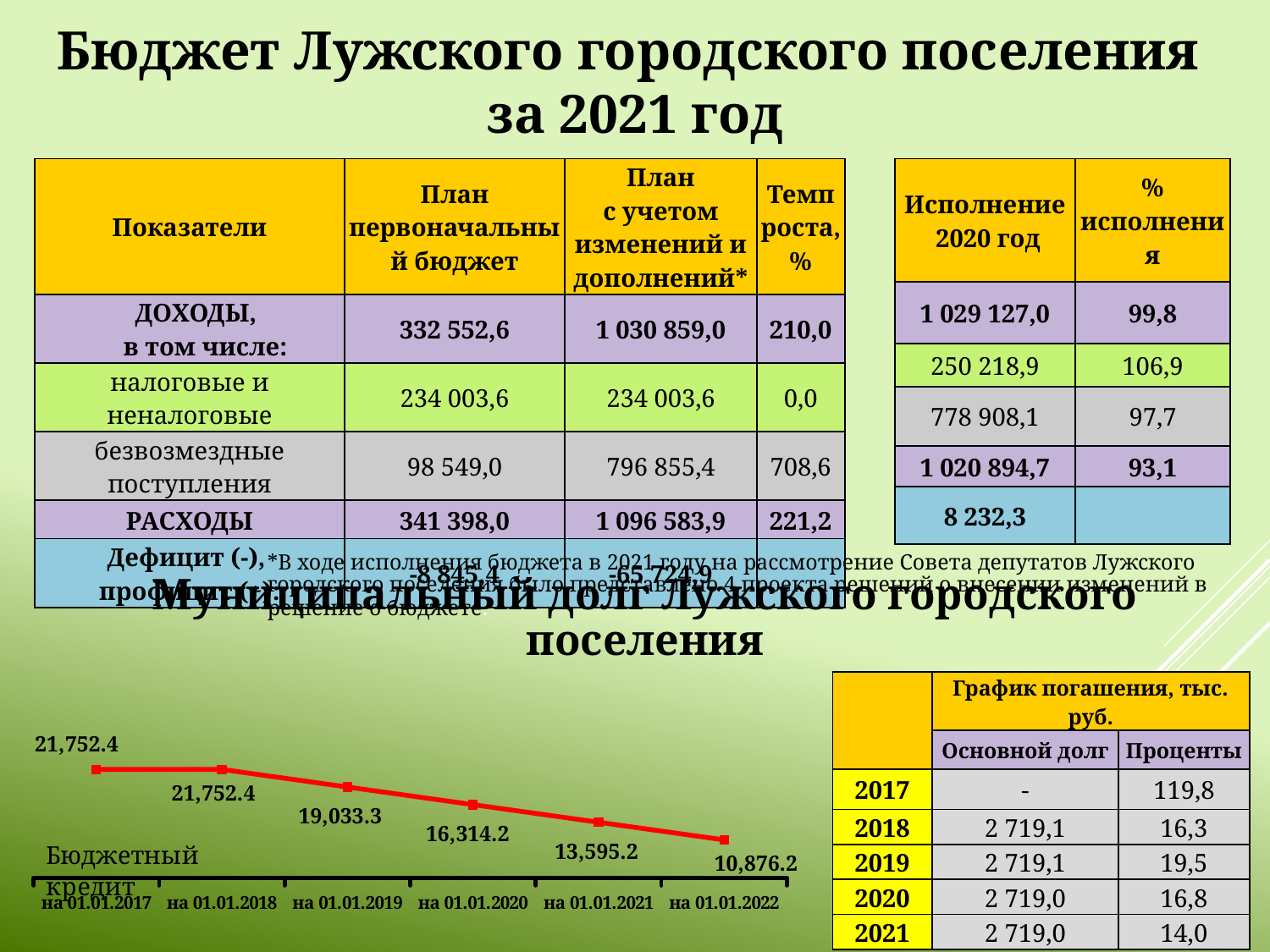
In the line chart, what is the value for на 01.01.2020? 16,314.2 In the line chart, what is the difference between the values for на 01.01.2017 and на 01.01.2022? 10,876.2 How many data points are plotted in the line chart? 6 In the line chart, which is larger: the value for на 01.01.2021 or the value for на 01.01.2022? на 01.01.2021 In the line chart, what is the difference between the values for на 01.01.2019 and на 01.01.2020? 2,719.1 In the line chart, what is the value for на 01.01.2022? 10,876.2 In the line chart, which date has the lowest value? на 01.01.2022 In the line chart, what is the value for на 01.01.2019? 19,033.3 In the line chart, do the values rise or fall from на 01.01.2018 to на 01.01.2022? fall In the line chart, what is the value for на 01.01.2021? 13,595.2 What kind of chart is shown at the bottom left of the slide? line chart